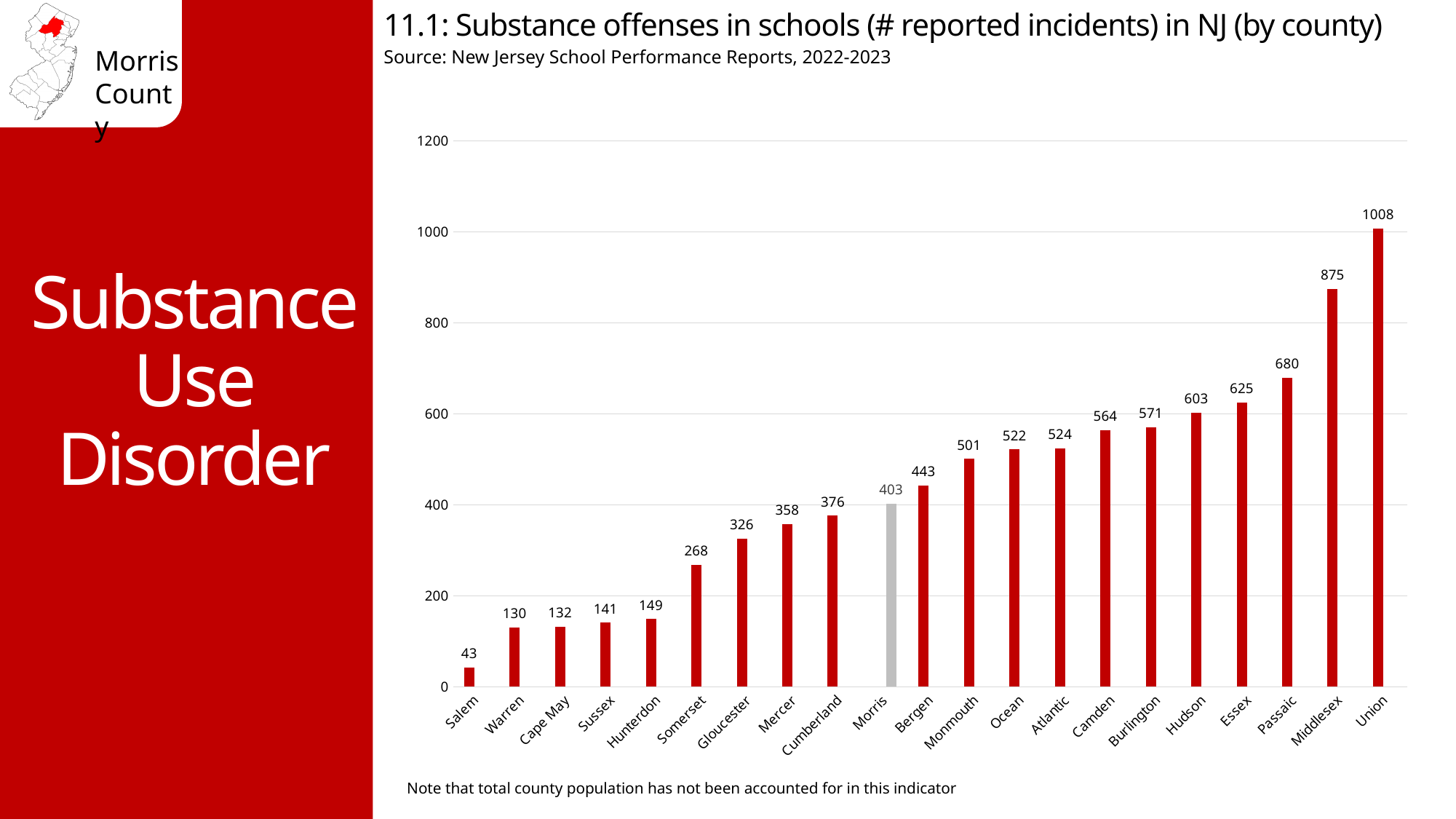
Which county's bar is shown in grey instead of red? Morris How many counties are shown on the chart? 21 What is the difference between the values for Union and Middlesex? 133 What is the number of reported substance offense incidents in schools for Morris County? 403 What is the value shown for Bergen County? 443 Is the value for Hudson greater or less than 600? greater Which county has the lowest number of reported incidents? Salem Which county has the highest number of reported incidents? Union Which county has more reported incidents, Passaic or Essex? Passaic Do the values rise or fall moving from left to right along the x axis? Rise What is the difference between the values for Morris and Cumberland? 27 What kind of chart is shown on the slide? Bar chart